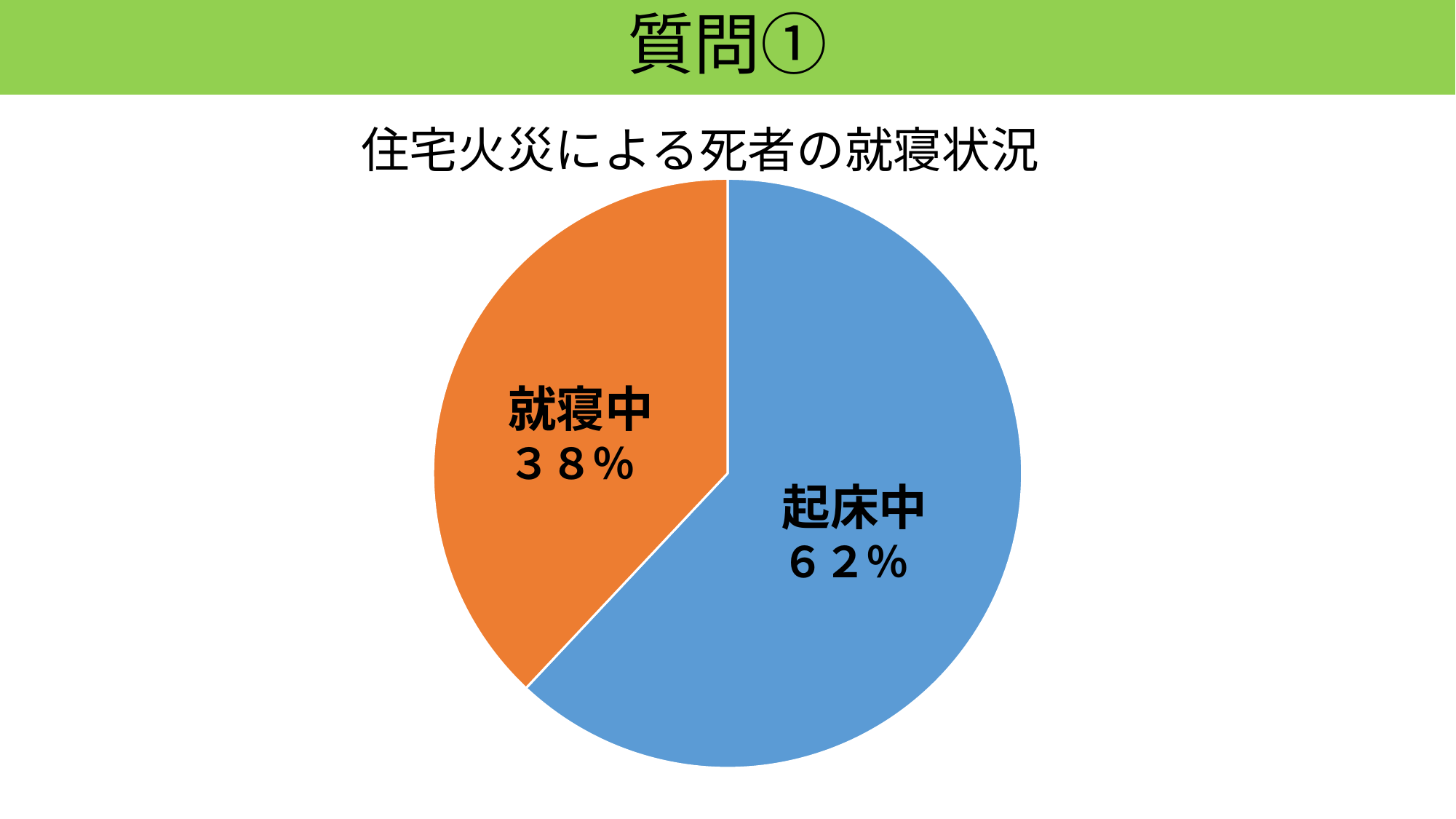
Which is larger, the value for 起床中 or the value for 就寝中? 起床中 What is the difference between the values for 起床中 and 就寝中? 24% What is the title of the chart? 住宅火災による死者の就寝状況 What is the value shown for 就寝中? 38% What is the value shown for 起床中? 62% What share of the pie does 就寝中 represent? 38% Which category has the smallest slice of the pie? 就寝中 How many categories are shown in the pie chart? 2 Which category has the largest slice of the pie? 起床中 What kind of chart is shown on the slide? pie chart What colour is the slice for 起床中? blue